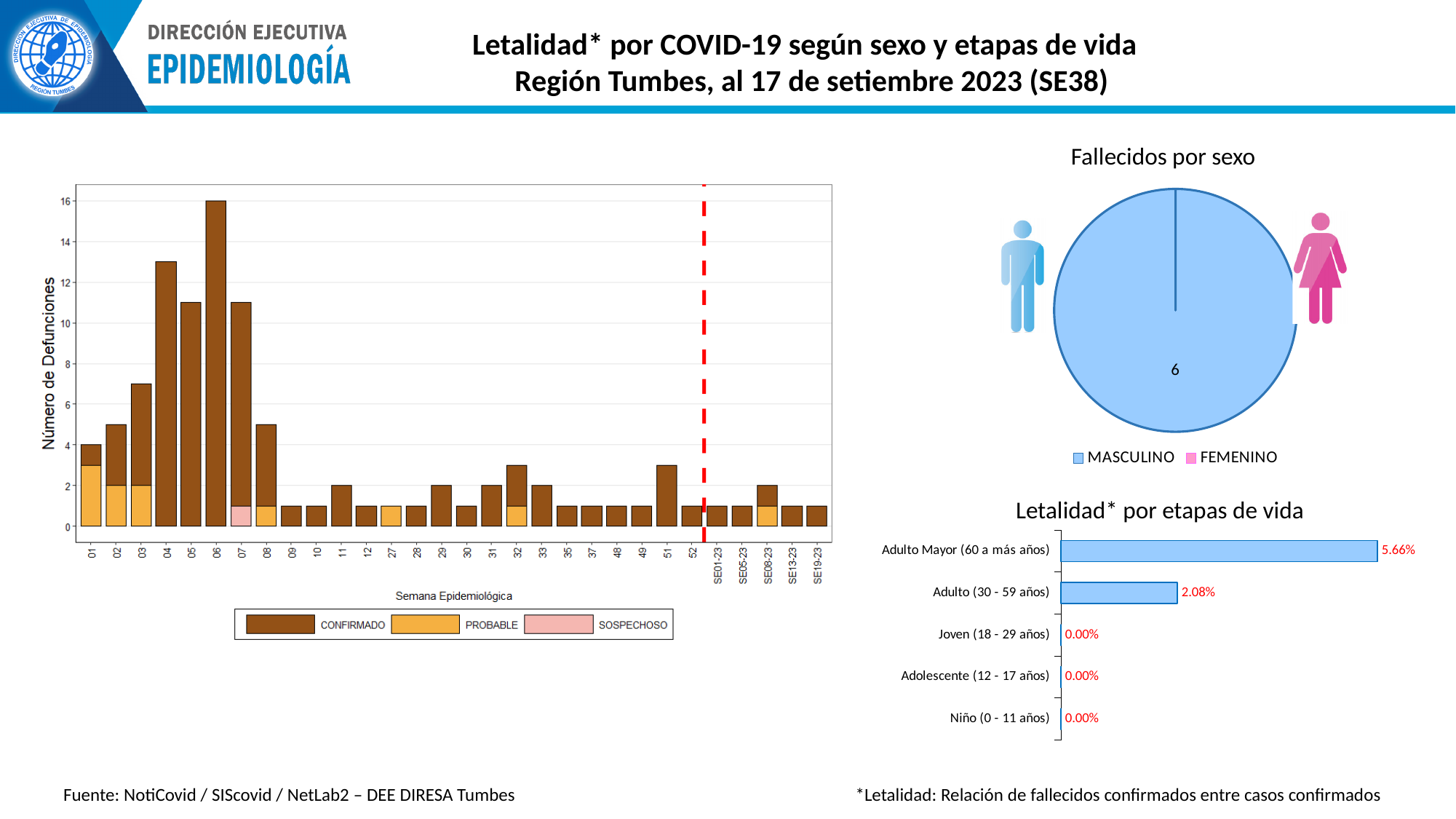
In the 'Letalidad* por etapas de vida' chart, how many age groups have a value of 0.00%? 3 In the 'Letalidad* por etapas de vida' chart, what is the value for Adulto (30 - 59 años)? 2.08% In the left chart of deaths by epidemiological week, how many deaths are shown for week 06? 16 In the 'Letalidad* por etapas de vida' chart, what is the difference between the values for Adulto Mayor (60 a más años) and Adulto (30 - 59 años)? 3.58% How many series does the legend of the left chart of deaths by epidemiological week list? 3 In the 'Letalidad* por etapas de vida' chart, which age group has the highest value? Adulto Mayor (60 a más años) In the 'Letalidad* por etapas de vida' chart, what is the value for Adulto Mayor (60 a más años)? 5.66% In the 'Fallecidos por sexo' pie chart, what value is shown for MASCULINO? 6 How many age groups are shown in the 'Letalidad* por etapas de vida' chart? 5 How many entries does the legend of the 'Fallecidos por sexo' chart list? 2 What kind of chart is 'Fallecidos por sexo'? Pie chart In the left chart of deaths by epidemiological week, which week has the highest number of deaths? 06